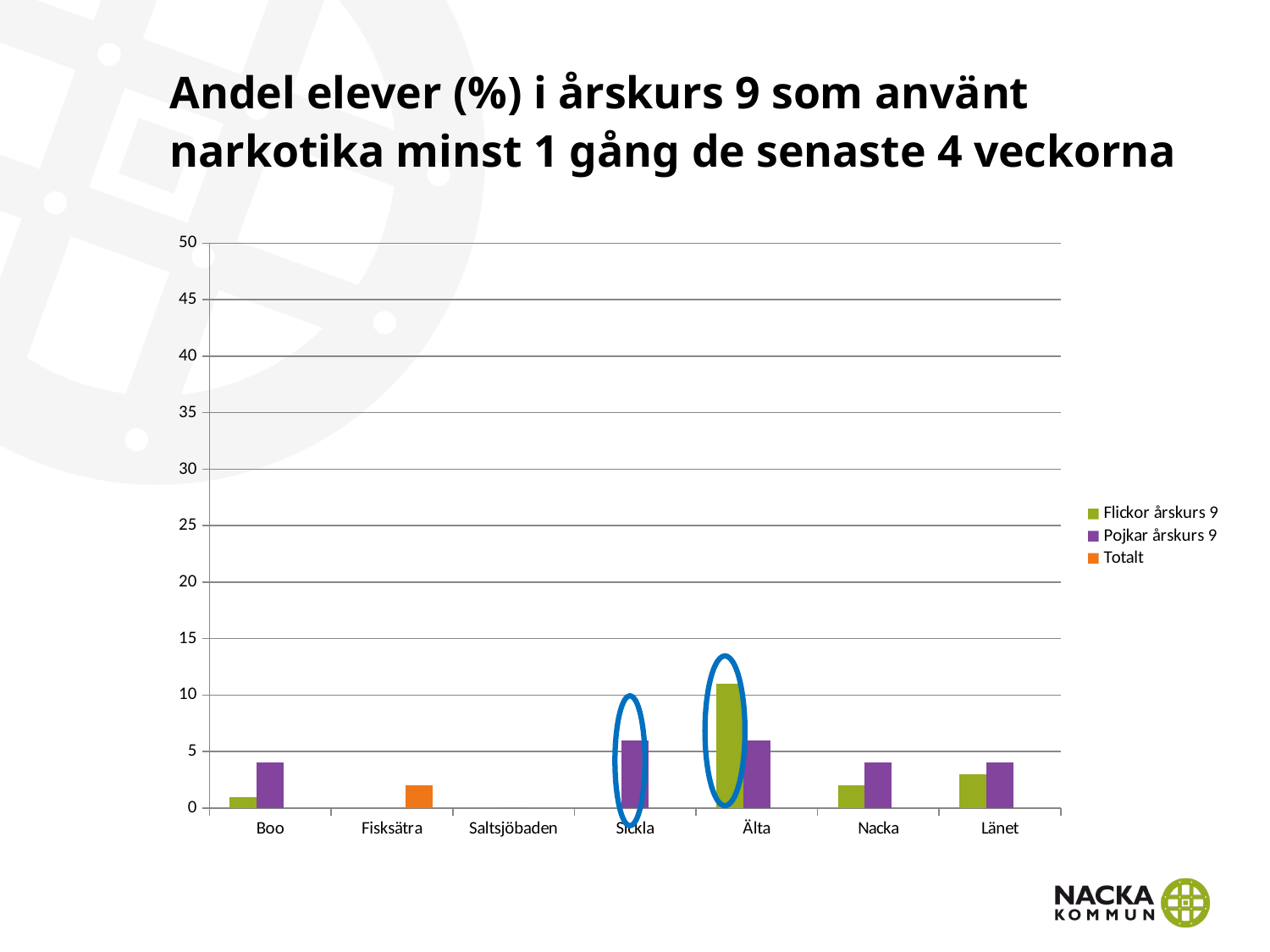
How many categories are shown on the x axis? 7 How many series does the legend list? 3 Is the value for Flickor årskurs 9 in Älta greater or less than 10? greater Is the value for Pojkar årskurs 9 in Boo greater or less than 5? less Which category has no bars at all? Saltsjöbaden In Boo, which is larger: Flickor årskurs 9 or Pojkar årskurs 9? Pojkar årskurs 9 What are the three legend entries of the chart? Flickor årskurs 9, Pojkar årskurs 9, Totalt Is the value for Flickor årskurs 9 in Länet greater or less than 5? less In Älta, which is larger: Flickor årskurs 9 or Pojkar årskurs 9? Flickor årskurs 9 What kind of chart is shown on the slide? bar chart Which category shows only a Totalt bar? Fisksätra Which category has the highest value for Flickor årskurs 9? Älta